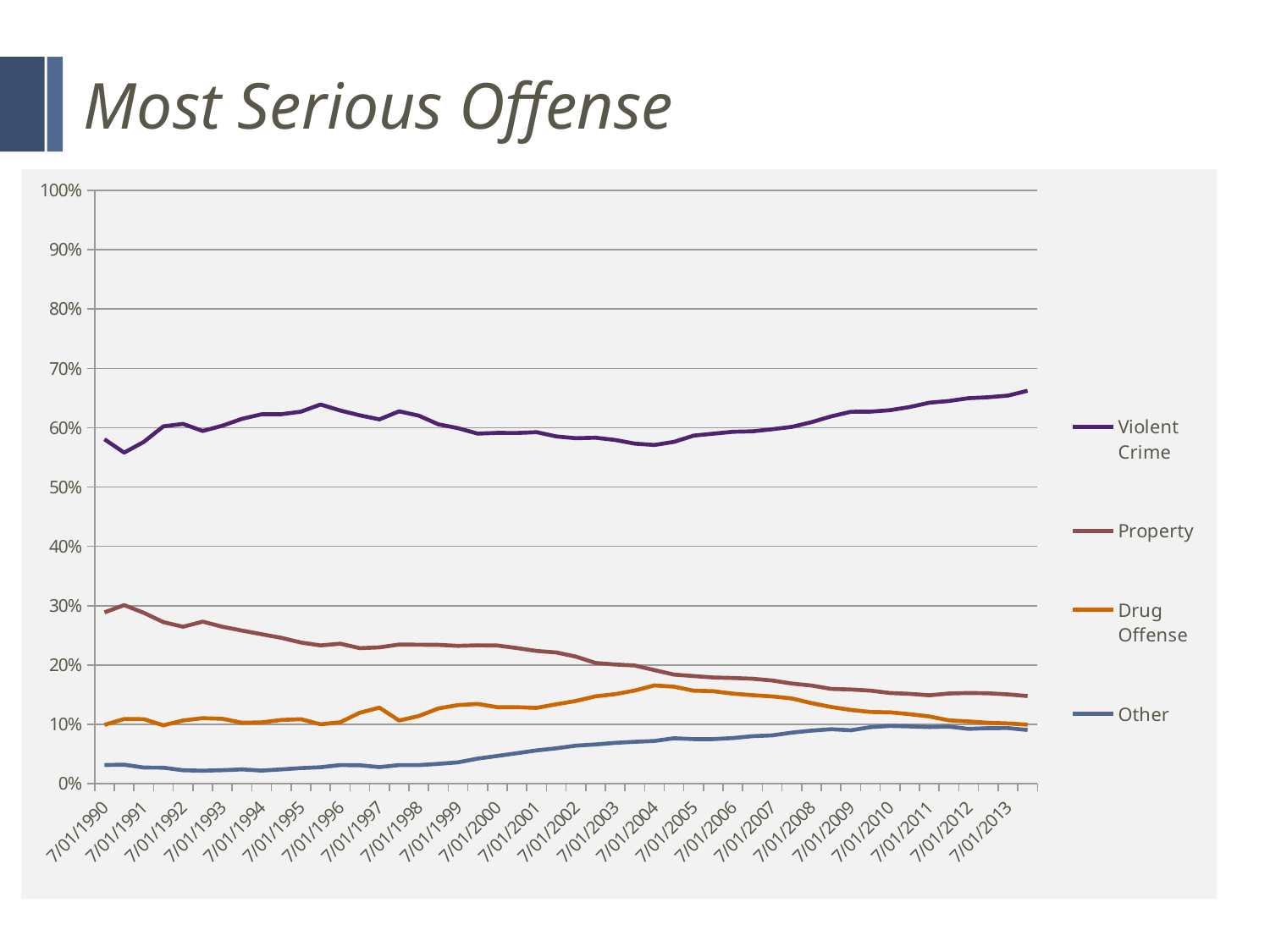
Is the value for Property at 7/01/2013 greater or less than 20%? less Is the value for Violent Crime at 7/01/2013 greater or less than 60%? greater Does the Other series rise or fall from 7/01/1990 to 7/01/2013? rise What is the title of the chart? Most Serious Offense Is the value for Other at 7/01/1990 greater or less than 10%? less Which series has the highest values across the whole period? Violent Crime Which series has the lowest value at 7/01/1990? Other What kind of chart is shown on the slide? line chart How many series does the legend list? 4 At 7/01/1990, which is larger: Property or Drug Offense? Property Does the Property series rise or fall from 7/01/1990 to 7/01/2013? fall